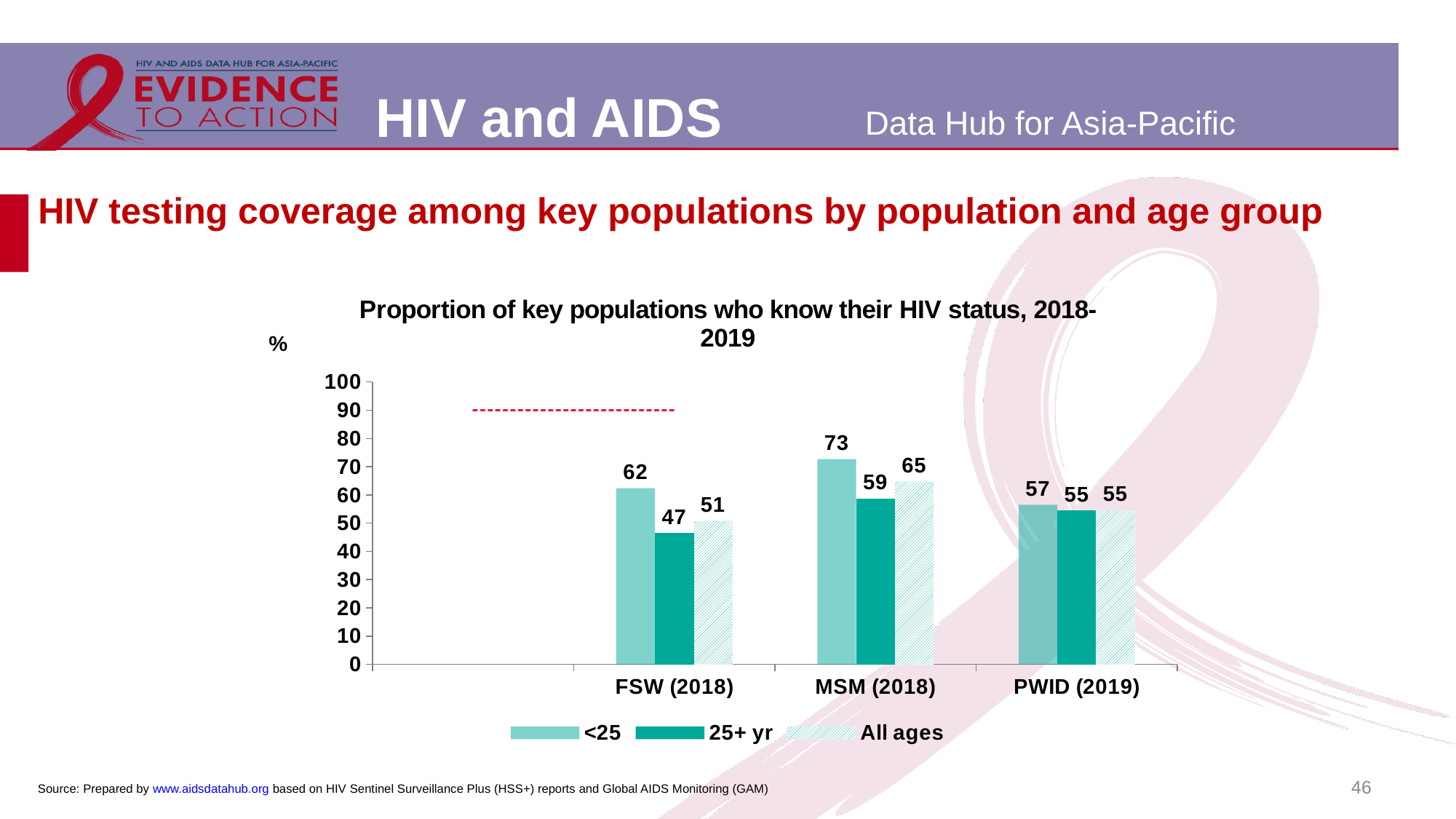
What is the difference between the <25 and 25+ yr values for FSW (2018)? 15 What is the All ages value for PWID (2019)? 55 Which is larger for MSM (2018): the 25+ yr value or the All ages value? All ages What is the title of the chart? Proportion of key populations who know their HIV status, 2018-2019 What kind of chart is shown on the slide? bar chart What is the value for the <25 series for MSM (2018)? 73 What is the value for the 25+ yr series for FSW (2018)? 47 Which population group has the highest <25 value? MSM (2018) How many population groups are shown on the x axis? 3 How many series does the legend list? 3 Which population group has the lowest 25+ yr value? FSW (2018) Is the All ages value for FSW (2018) greater or less than 60? less